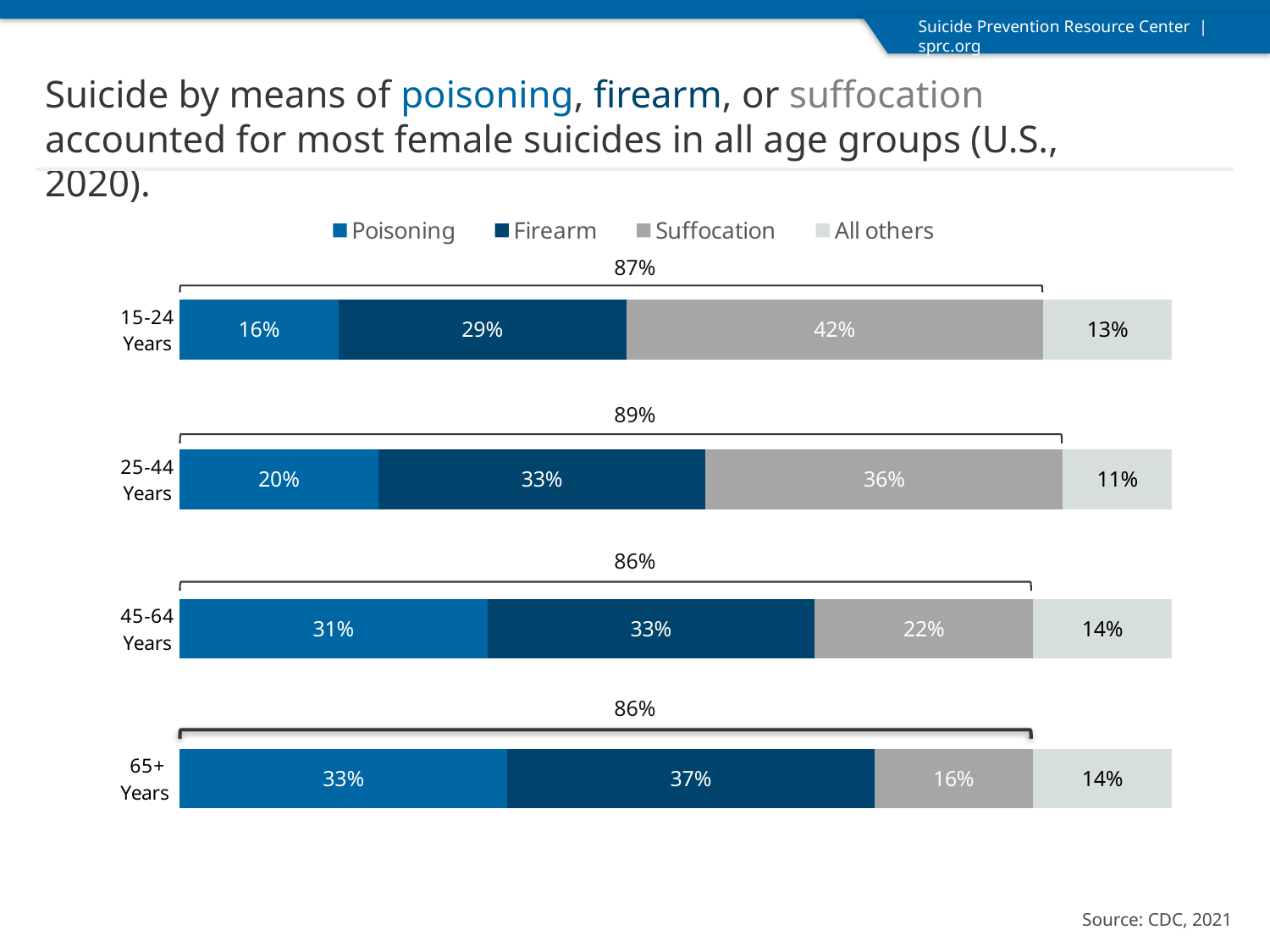
What percentage of female suicides in the 65+ Years group were by firearm? 37% Which is larger in the 45-64 Years group, the poisoning share or the suffocation share? Poisoning How many series does the legend list? 4 What combined percentage is shown by the bracket above the 25-44 Years bar? 89% What percentage of female suicides in the 15-24 Years group were by suffocation? 42% What kind of chart is shown on the slide? Stacked bar chart What percentage of female suicides in the 25-44 Years group were by poisoning? 20% How many age groups are shown in the chart? 4 What is the difference between the suffocation percentage and the poisoning percentage in the 15-24 Years group? 26% Which age group has the lowest suffocation percentage? 65+ Years What is the 'All others' share for the 45-64 Years group? 14% Which age group has the highest poisoning percentage? 65+ Years